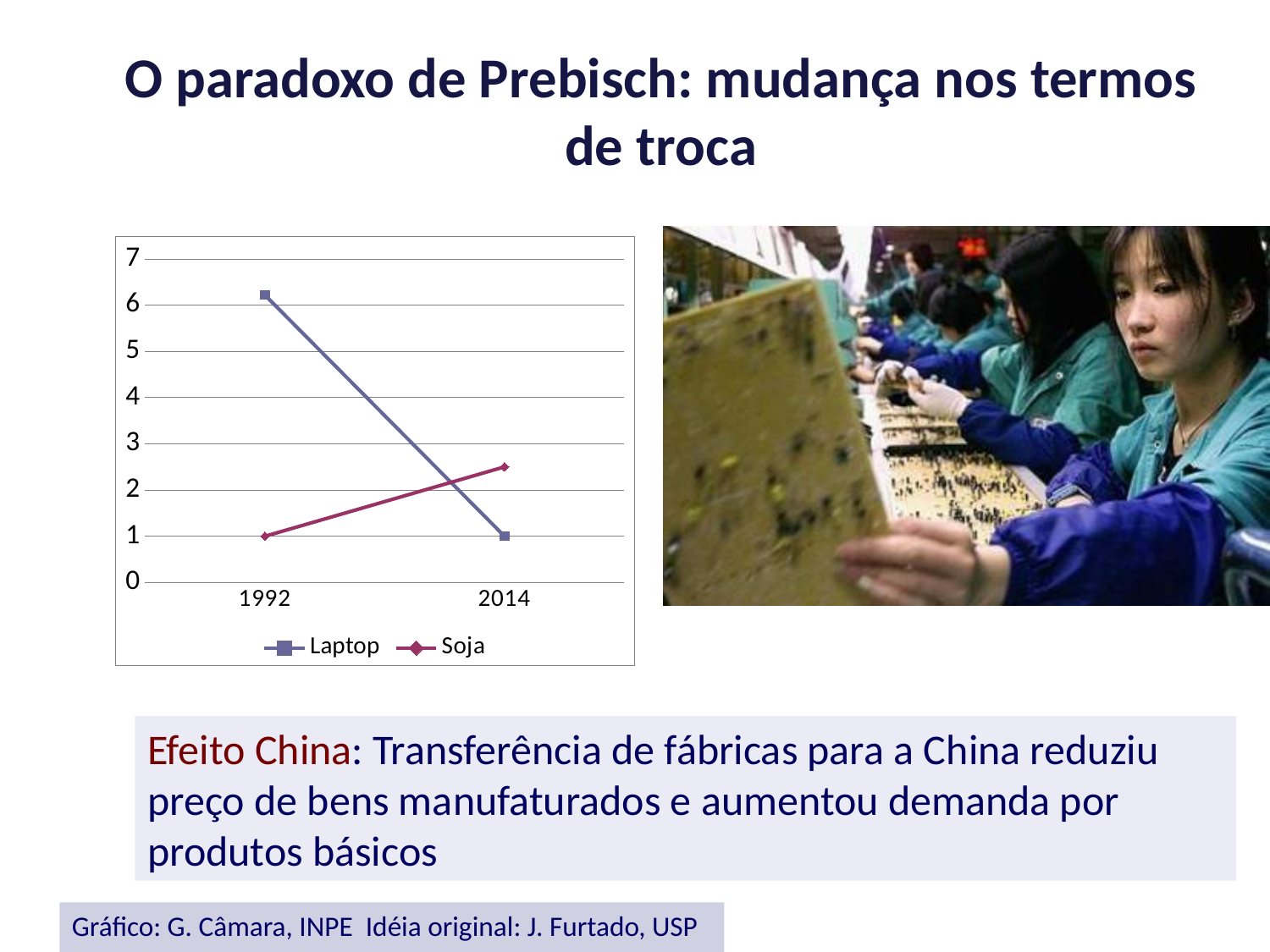
Does the Laptop series rise or fall from 1992 to 2014? fall What is the value for Soja in 1992? 1 How many years are shown on the x axis of the chart? 2 Does the Soja series rise or fall from 1992 to 2014? rise What kind of chart is shown on the slide? line chart Which series are listed in the chart's legend? Laptop and Soja In 2014, which series has the larger value, Laptop or Soja? Soja Is the value for Laptop in 1992 greater or less than 5? greater What is the value for Laptop in 2014? 1 Is the value for Soja in 2014 greater or less than 3? less How many series does the chart's legend list? 2 Is the value for Soja in 2014 greater or less than 2? greater